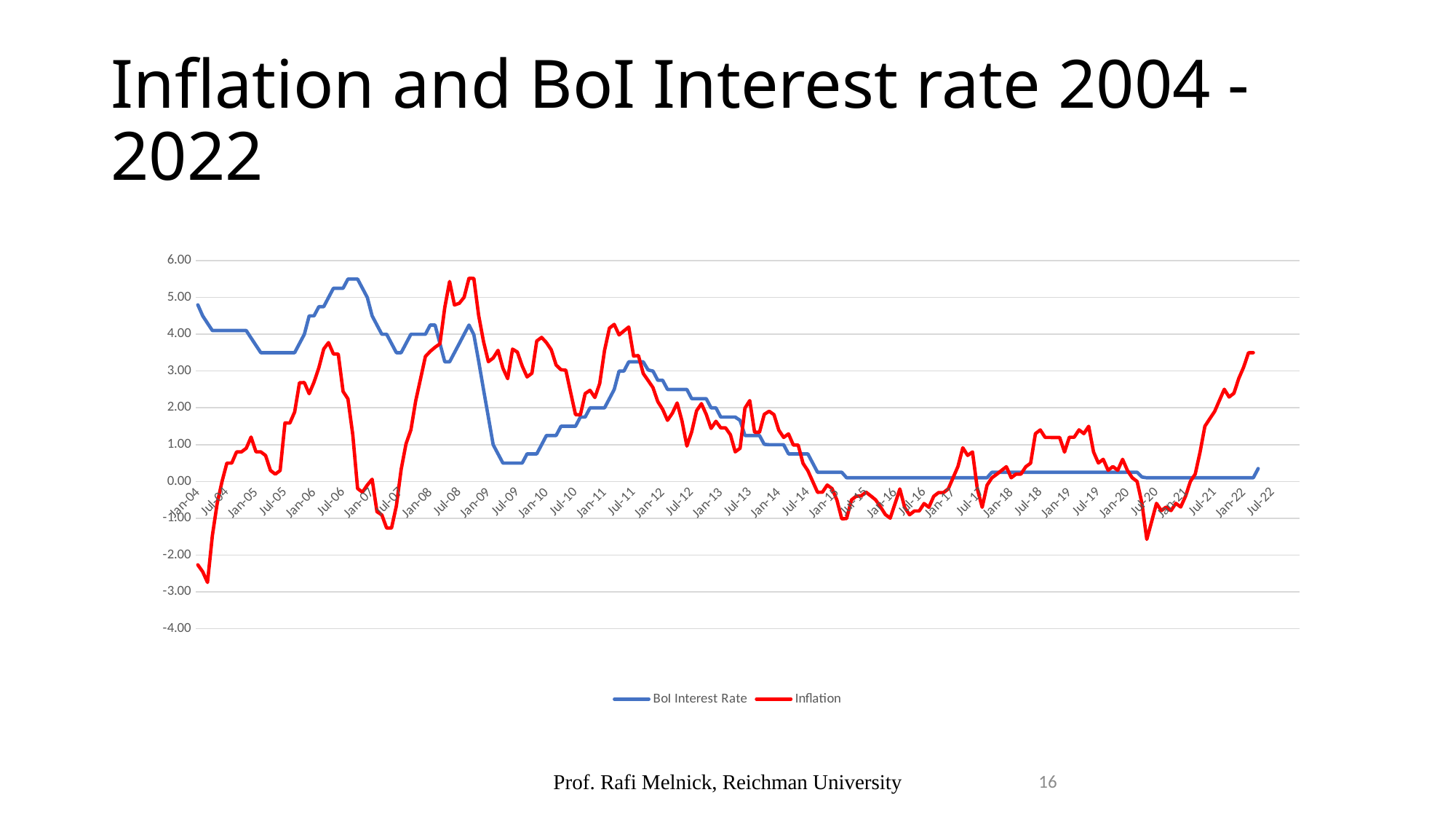
How many series does the legend list? 2 What kind of chart is shown on the slide? Line chart At Jan-04, which series has the higher value, BoI Interest Rate or Inflation? BoI Interest Rate Which series reaches the lowest value anywhere on the chart? Inflation Is the BoI Interest Rate at Jan-04 greater or less than 4.00? greater What are the two series named in the legend? BoI Interest Rate and Inflation Which colour is used for the Inflation series? Red Is the Inflation value at Jan-04 greater or less than -1.00? less